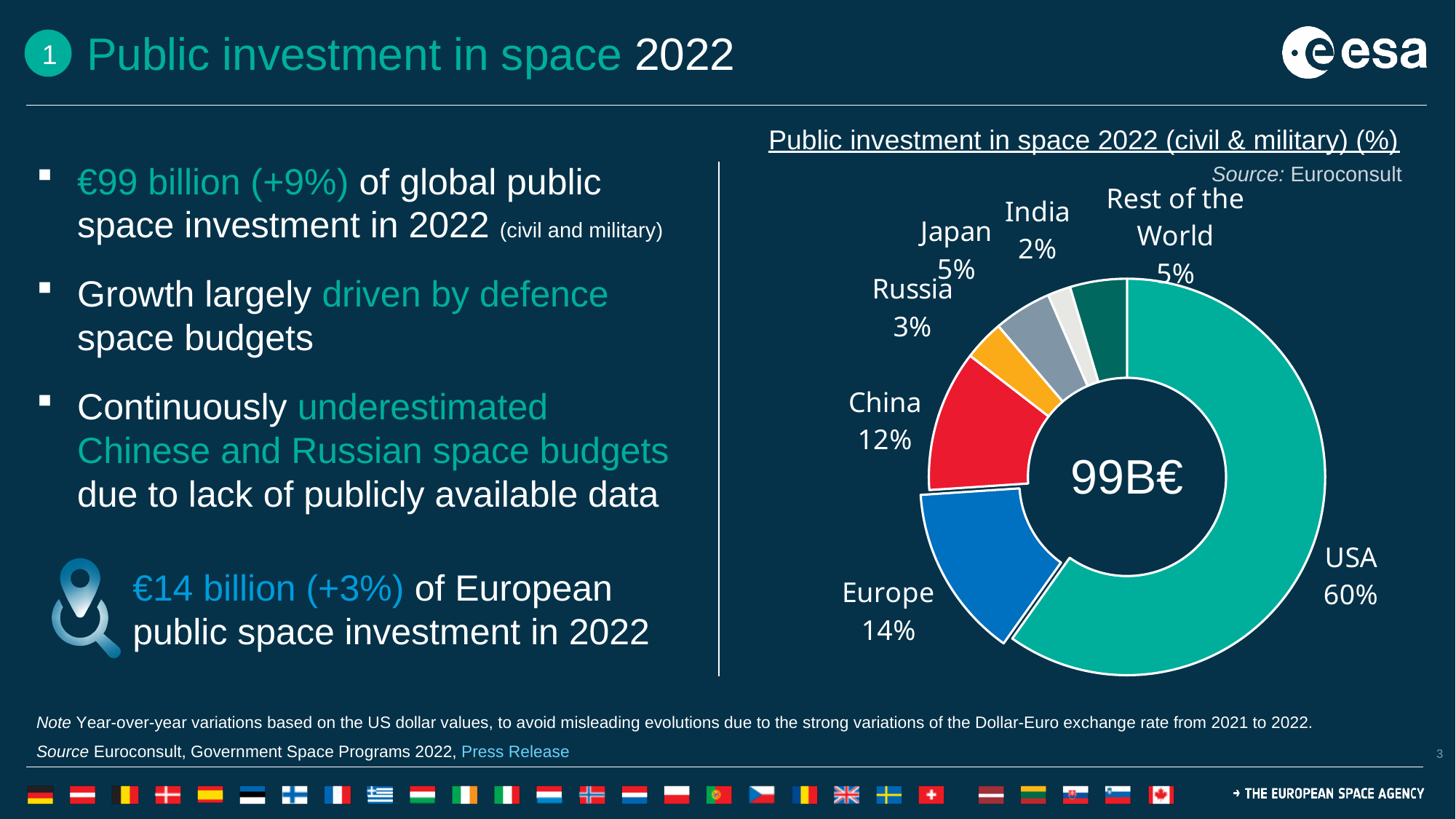
What kind of chart is shown on the slide? Pie chart (doughnut) What share of public investment in space 2022 does Europe hold? 14% Which region has the largest share of public investment in space 2022? USA Which has a larger share of public investment in space 2022, Europe or China? Europe What is the difference in percentage points between the USA's share and Europe's share? 46 What share of public investment in space 2022 does the USA hold? 60% What total value is printed in the centre of the chart? 99B€ What share of public investment in space 2022 does China hold? 12% What share of public investment in space 2022 does India hold? 2% What share of public investment in space 2022 does Russia hold? 3% How many categories are shown in the chart? 7 Which region has the smallest share of public investment in space 2022? India